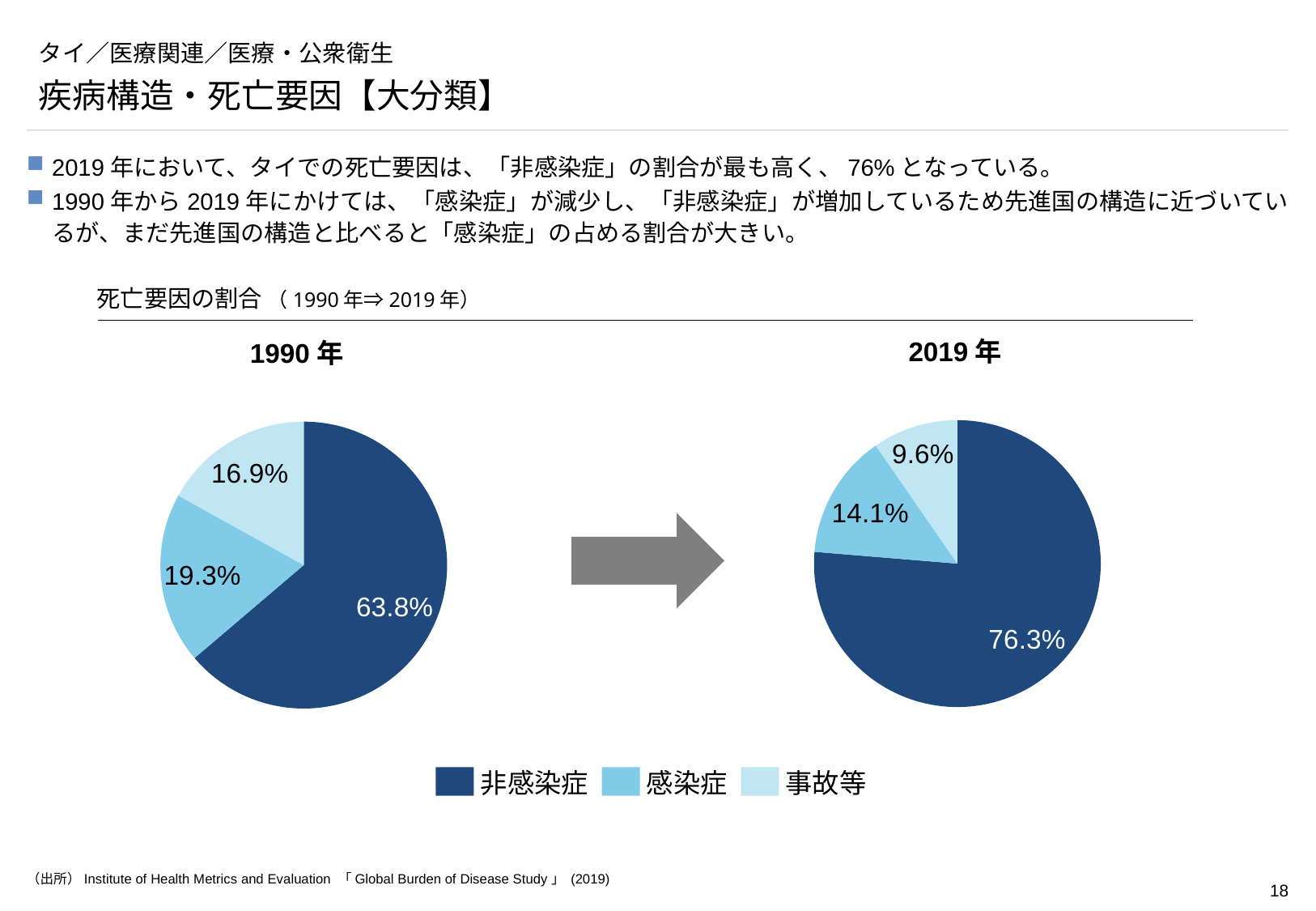
In the 1990年 pie chart, what is the share for 事故等? 16.9% In the 2019年 pie chart, which category has the largest share? 非感染症 In the 1990年 pie chart, what is the share for 非感染症? 63.8% Is the 感染症 share larger in the 1990年 pie chart or the 2019年 pie chart? 1990年 In the 2019年 pie chart, what is the share for 事故等? 9.6% What type of chart is used to show 死亡要因の割合 for 1990年 and 2019年? Pie chart In the 1990年 pie chart, what is the difference between the 感染症 share and the 事故等 share? 2.4 percentage points In the 2019年 pie chart, what is the share for 感染症? 14.1% How many slices does the 2019年 pie chart have? 3 In the 1990年 pie chart, which category has the smallest share? 事故等 How many categories does the legend list? 3 How much larger is the 非感染症 share in the 2019年 pie chart than in the 1990年 pie chart? 12.5 percentage points